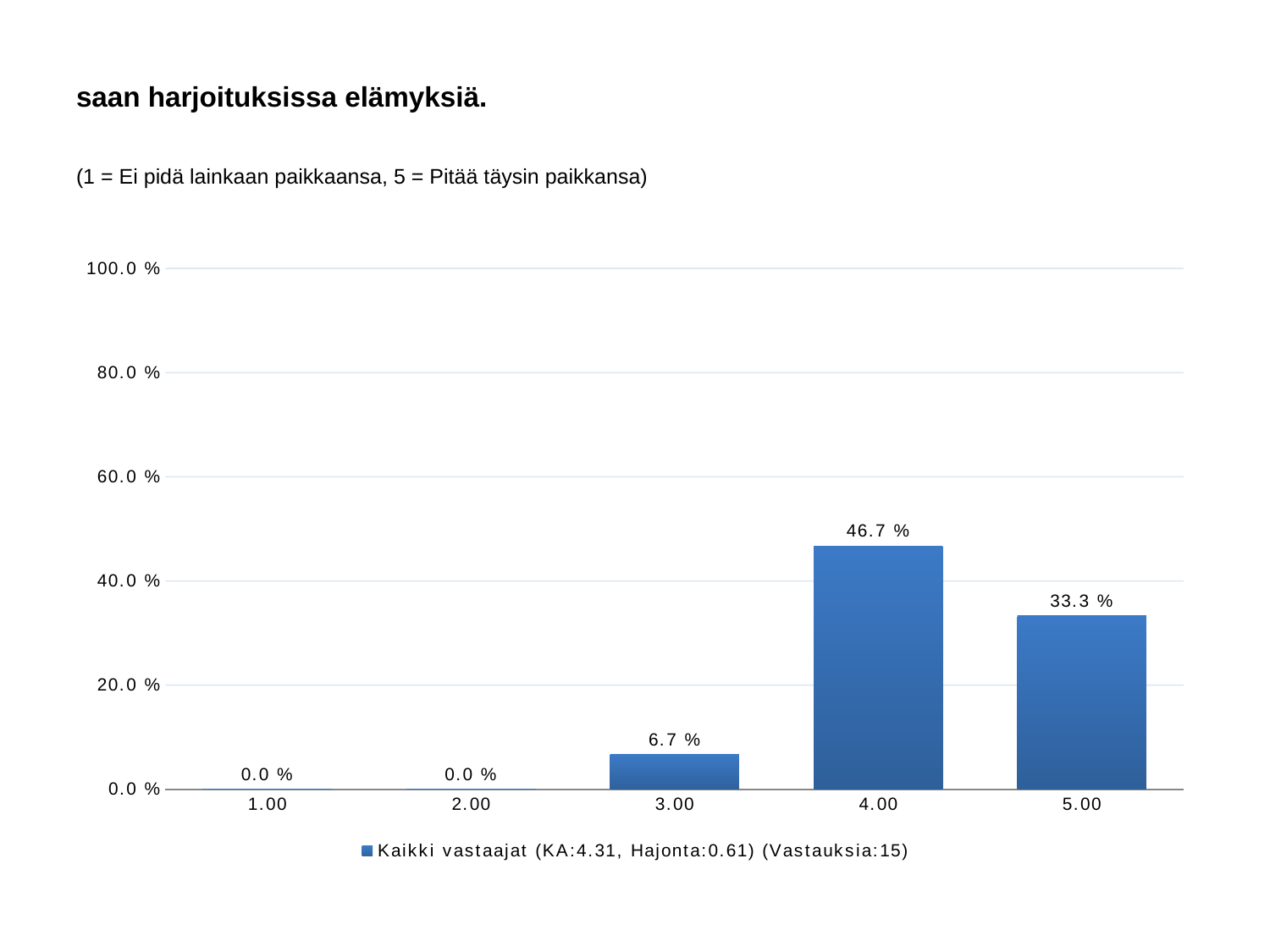
Which category has the highest value? 4.00 What is the value for category 4.00? 46.7 % What is the difference between the values for 4.00 and 5.00? 13.4 % What is the legend entry for the series? Kaikki vastaajat (KA:4.31, Hajonta:0.61) (Vastauksia:15) How many series does the legend list? 1 What kind of chart is shown? bar chart What is the value for category 1.00? 0.0 % What is the value for category 5.00? 33.3 % What is the value for category 3.00? 6.7 % Is the value for 4.00 greater or less than 40.0 %? greater Which is larger, the value for 3.00 or the value for 5.00? 5.00 How many categories are shown on the x axis? 5